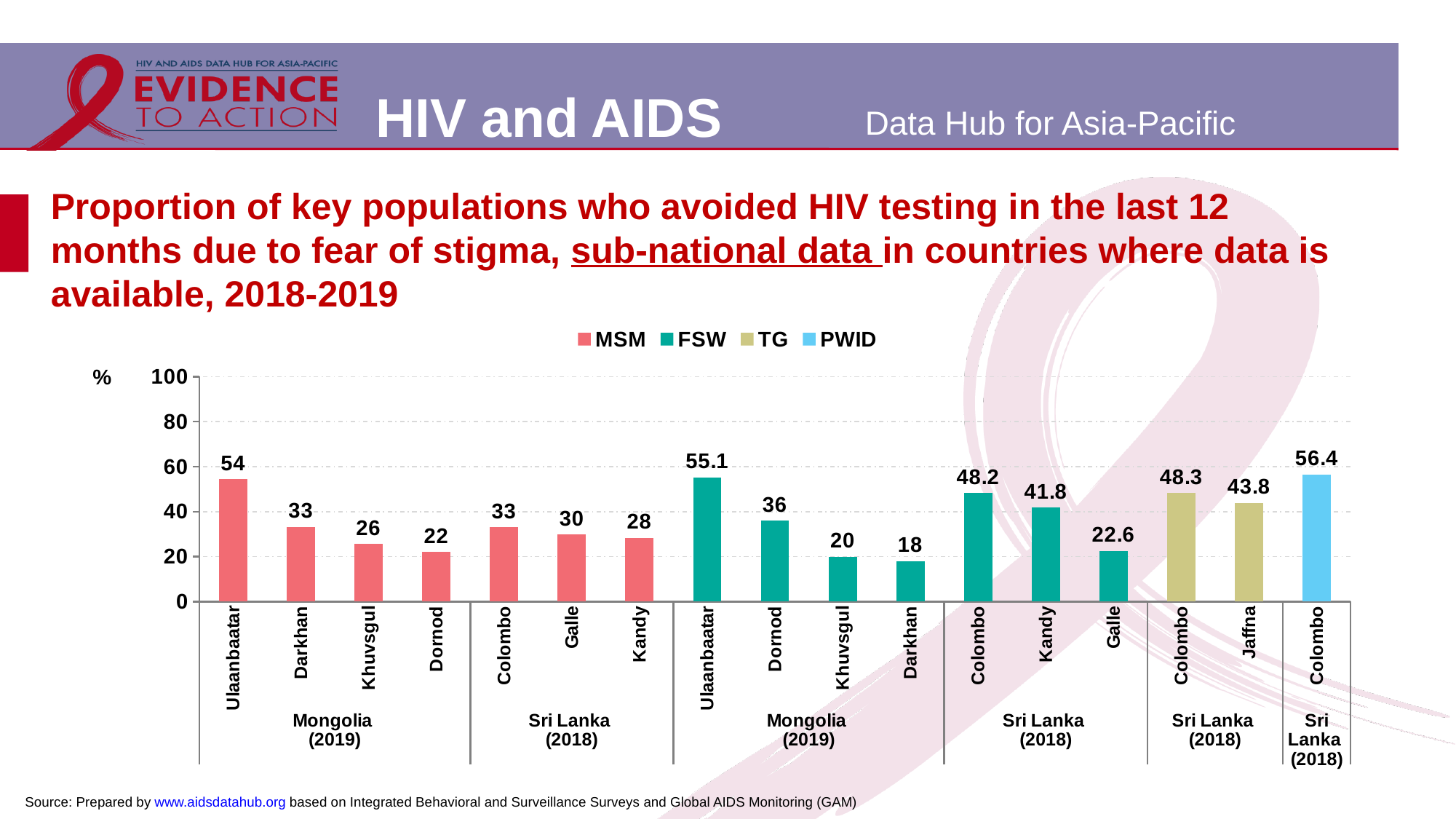
What kind of chart is shown on the slide? Bar chart What is the difference between Ulaanbaatar in the FSW series and Ulaanbaatar in the MSM series? 1.1 Is the value for Colombo in the TG series greater or less than 40? greater Which bar has the highest value on the chart? Colombo (PWID), 56.4 Which is larger: Kandy in the MSM series or Kandy in the FSW series? Kandy in the FSW series How many series does the legend list? 4 How many bars are plotted on the chart? 17 What is the value for Jaffna in the TG series? 43.8 What is the value for Galle in the FSW series? 22.6 Which bar has the lowest value on the chart? Darkhan (FSW), 18 What is the value for Colombo in the PWID series? 56.4 What is the value for Ulaanbaatar in the MSM series? 54